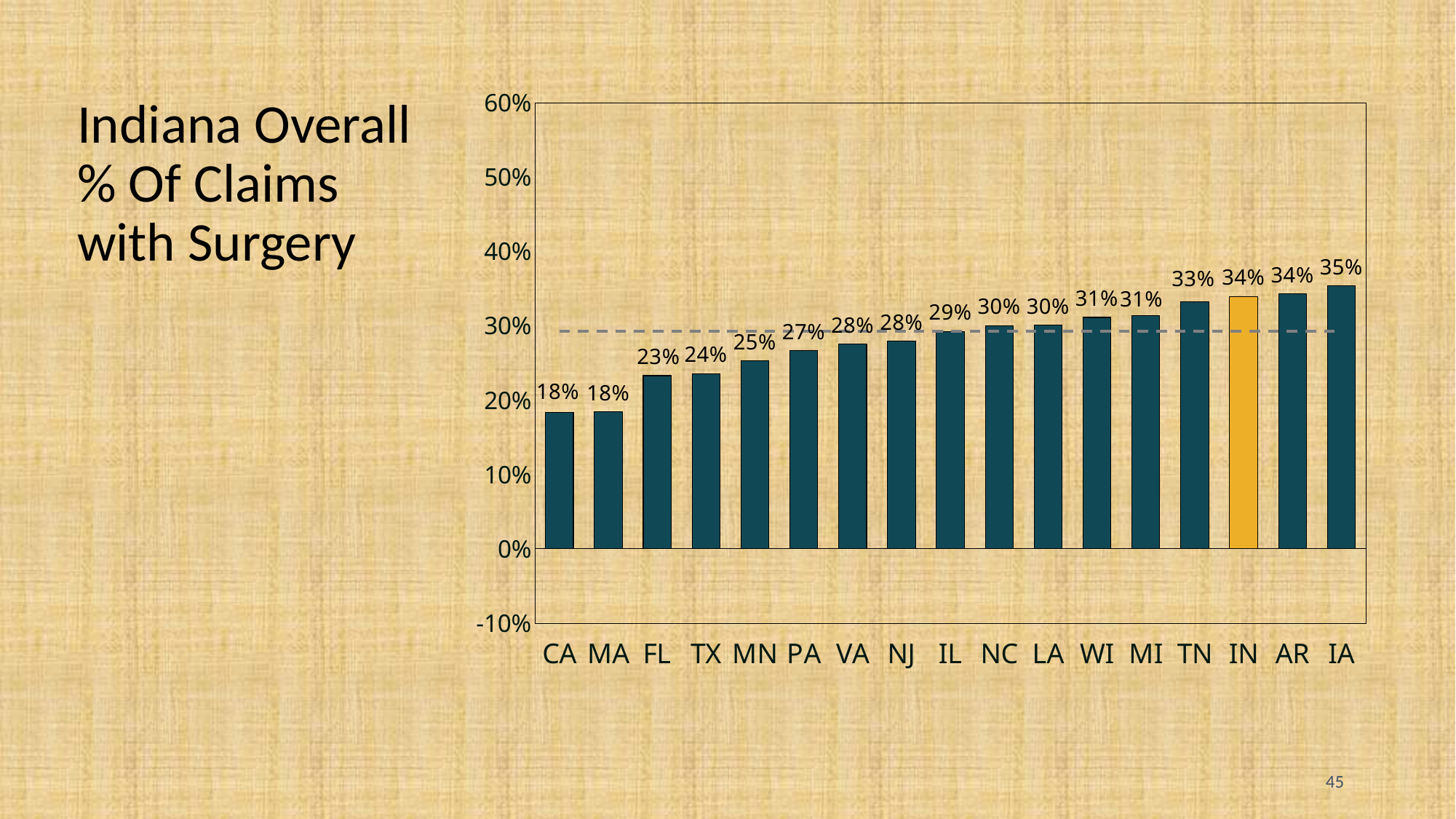
Which bar is coloured differently from the others? IN Which state has the highest value? IA Which is larger, the value for TN or the value for PA? TN What is the value for IN? 34% What is the difference between the values for IA and CA? 17% What is the value for FL? 23% How many states are shown on the x axis? 17 What is the title of the slide? Indiana Overall % Of Claims with Surgery Do the values rise or fall from left to right along the x axis? rise What is the value for MI? 31% Is the value for MN greater or less than 30%? less What kind of chart is this? bar chart